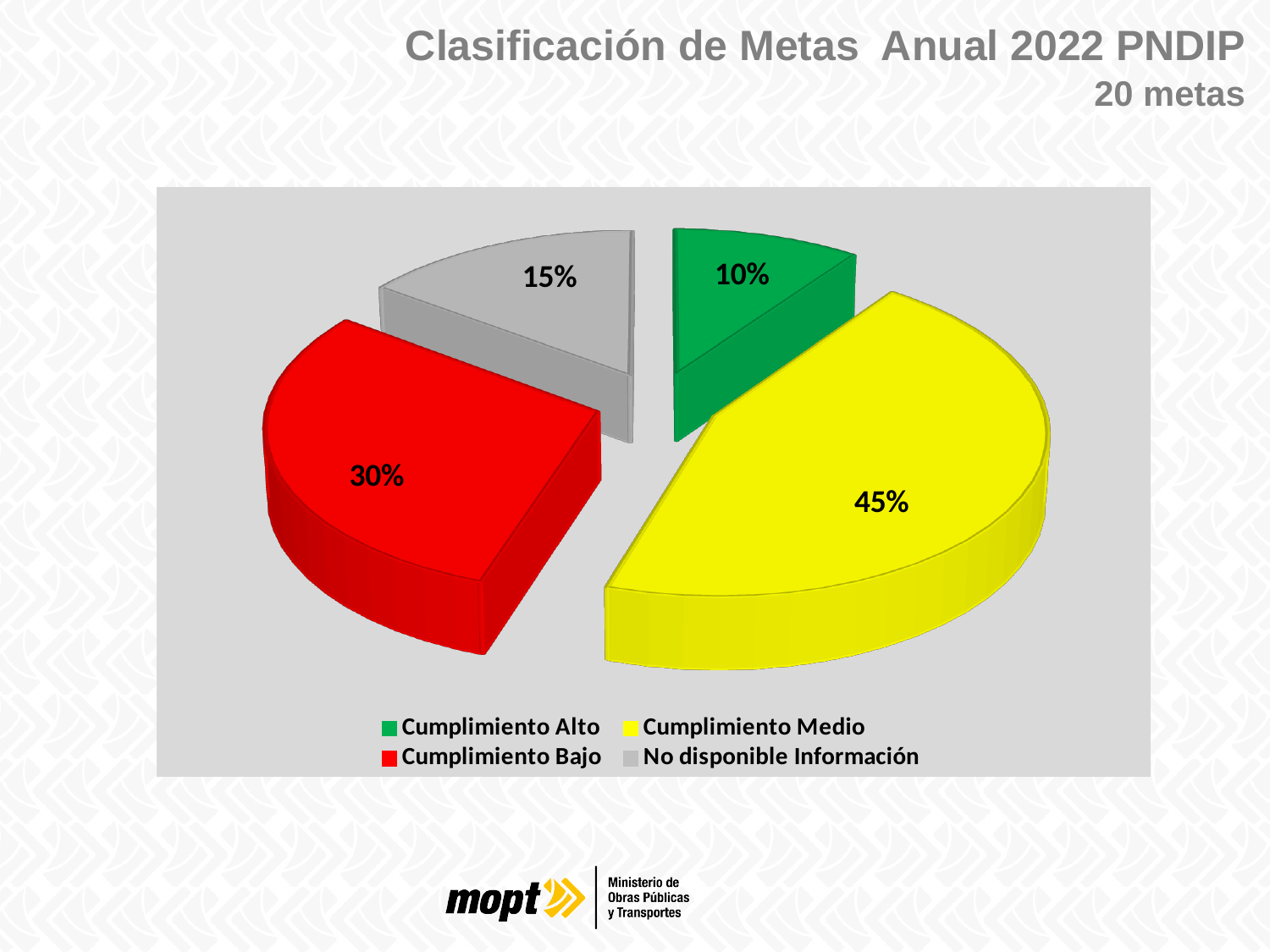
Which is larger, Cumplimiento Bajo or No disponible Información? Cumplimiento Bajo What is the value shown for Cumplimiento Alto? 10% What is the difference between the Cumplimiento Medio and Cumplimiento Bajo percentages? 15% What is the value shown for No disponible Información? 15% What share of the pie does Cumplimiento Medio represent? 45% How many categories does the pie chart show? 4 Which category has the smallest slice of the pie? Cumplimiento Alto How many metas does the slide say the chart covers? 20 metas Which category has the largest slice of the pie? Cumplimiento Medio What kind of chart is shown on the slide? Pie chart What is the value shown for Cumplimiento Bajo? 30% What colour is the Cumplimiento Bajo slice? Red